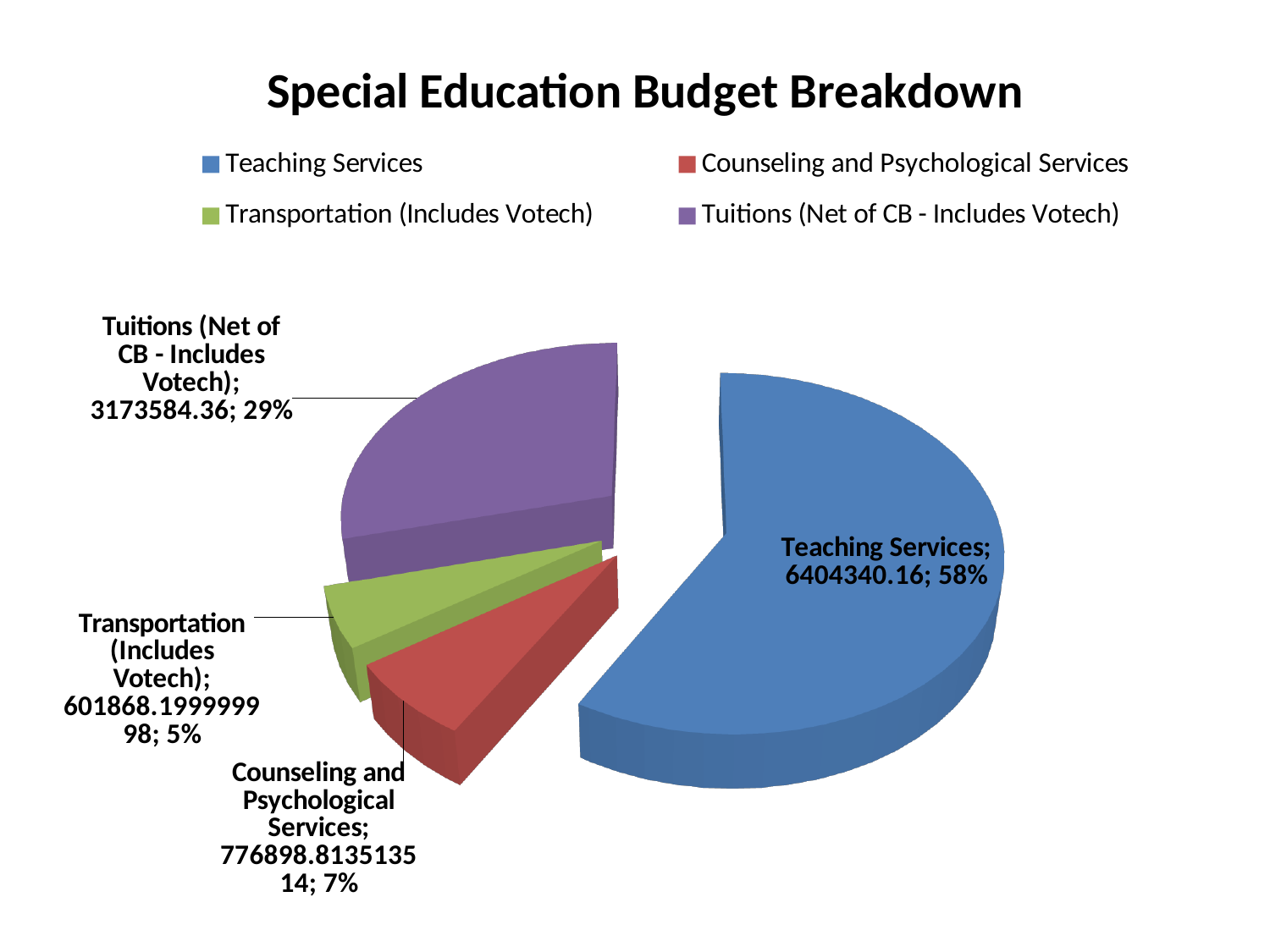
Which is larger, Tuitions (Net of CB - Includes Votech) or Counseling and Psychological Services? Tuitions (Net of CB - Includes Votech) What is the title of the chart? Special Education Budget Breakdown What type of chart is shown? Pie chart What percentage share does Counseling and Psychological Services have? 7% What is the value for Teaching Services? 6404340.16 How many categories are shown in the pie chart? 4 What percentage share does Transportation (Includes Votech) have? 5% What percentage share does Teaching Services have? 58% What is the difference between the Teaching Services value and the Tuitions (Net of CB - Includes Votech) value? 3230755.80 Which category has the smallest slice? Transportation (Includes Votech) Which category has the largest slice? Teaching Services What is the value for Tuitions (Net of CB - Includes Votech)? 3173584.36